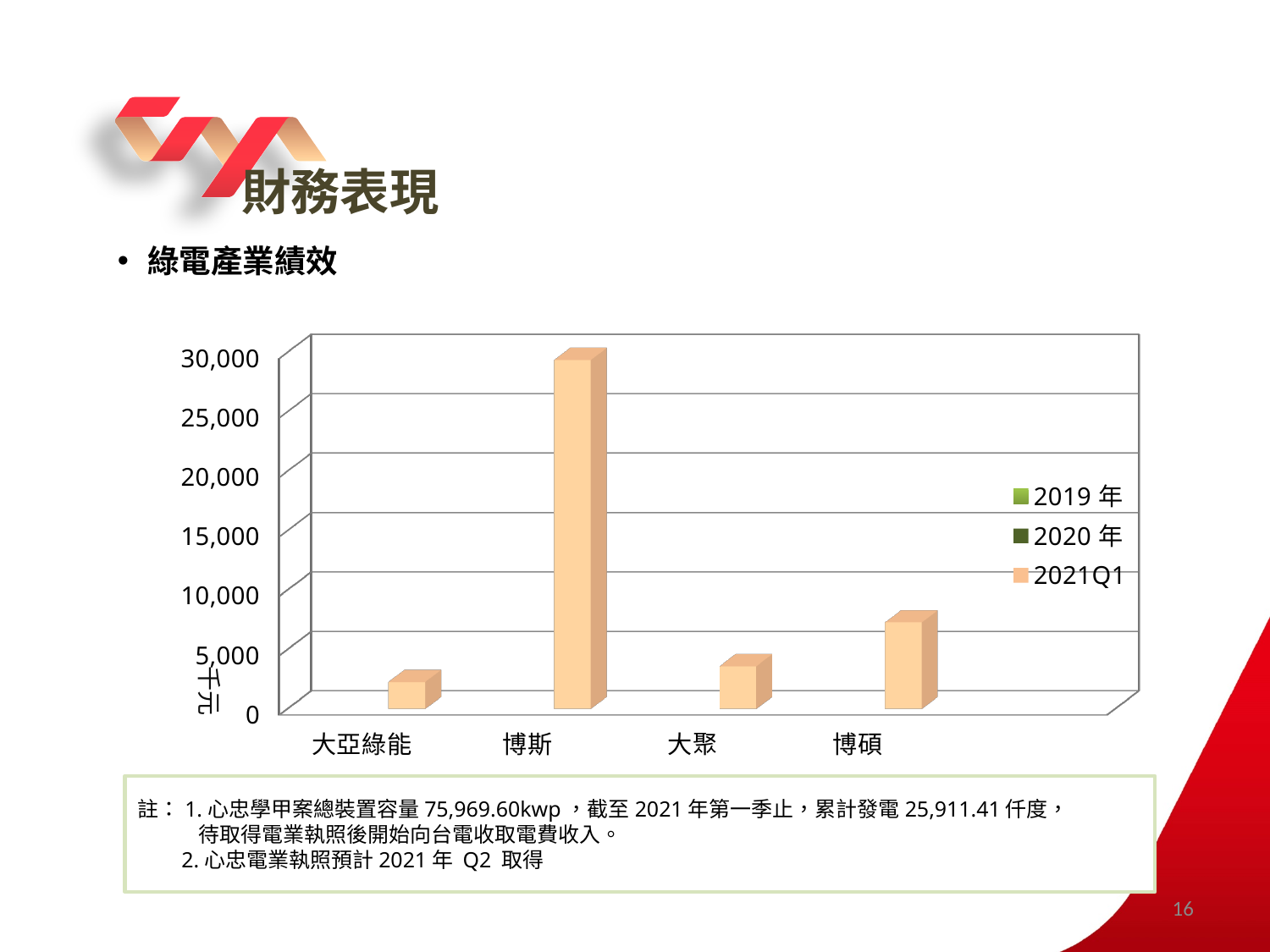
What kind of chart is shown on the slide? bar chart Is the value for 博碩 greater or less than 5,000? greater Is the value for 大亞綠能 greater or less than 5,000? less Which is larger, the value for 博碩 or the value for 大聚? 博碩 Is the value for 博斯 greater or less than 25,000? greater Which category has the lowest bar in the chart? 大亞綠能 What unit label is shown on the vertical axis of the chart? 千元 How many categories are shown on the x axis of the chart? 4 Which series in the legend is shown in light orange? 2021Q1 Which category has the highest bar in the chart? 博斯 How many series does the chart's legend list? 3